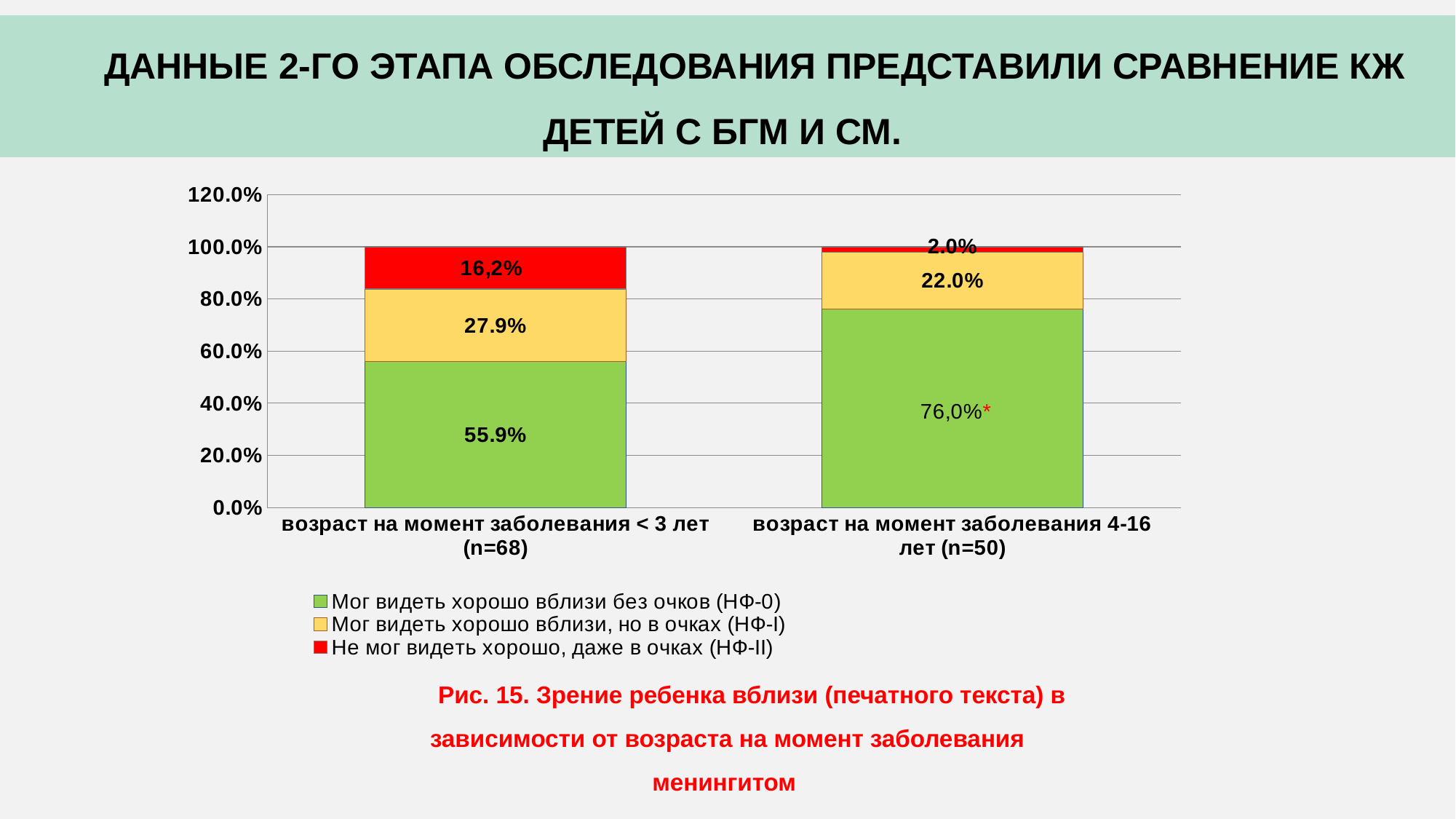
What colour represents 'Мог видеть хорошо вблизи, но в очках (НФ-I)' in the chart? yellow What is the value for 'Мог видеть хорошо вблизи, но в очках (НФ-I)' in the group 'возраст на момент заболевания < 3 лет (n=68)'? 27.9% What is the value for 'Не мог видеть хорошо, даже в очках (НФ-II)' in the group 'возраст на момент заболевания 4-16 лет (n=50)'? 2.0% How many categories are shown on the x axis? 2 What kind of chart is shown on the slide? stacked bar chart Which group has the higher value for 'Мог видеть хорошо вблизи без очков (НФ-0)'? возраст на момент заболевания 4-16 лет (n=50) What is the value for 'Мог видеть хорошо вблизи без очков (НФ-0)' in the group 'возраст на момент заболевания < 3 лет (n=68)'? 55.9% How many series does the legend list? 3 What is the difference between the 'Не мог видеть хорошо, даже в очках (НФ-II)' values of the two groups? 14.2 percentage points What is the value for 'Не мог видеть хорошо, даже в очках (НФ-II)' in the group 'возраст на момент заболевания < 3 лет (n=68)'? 16,2% What is the value for 'Мог видеть хорошо вблизи без очков (НФ-0)' in the group 'возраст на момент заболевания 4-16 лет (n=50)'? 76,0% Which series has the smallest value in the group 'возраст на момент заболевания 4-16 лет (n=50)'? Не мог видеть хорошо, даже в очках (НФ-II)